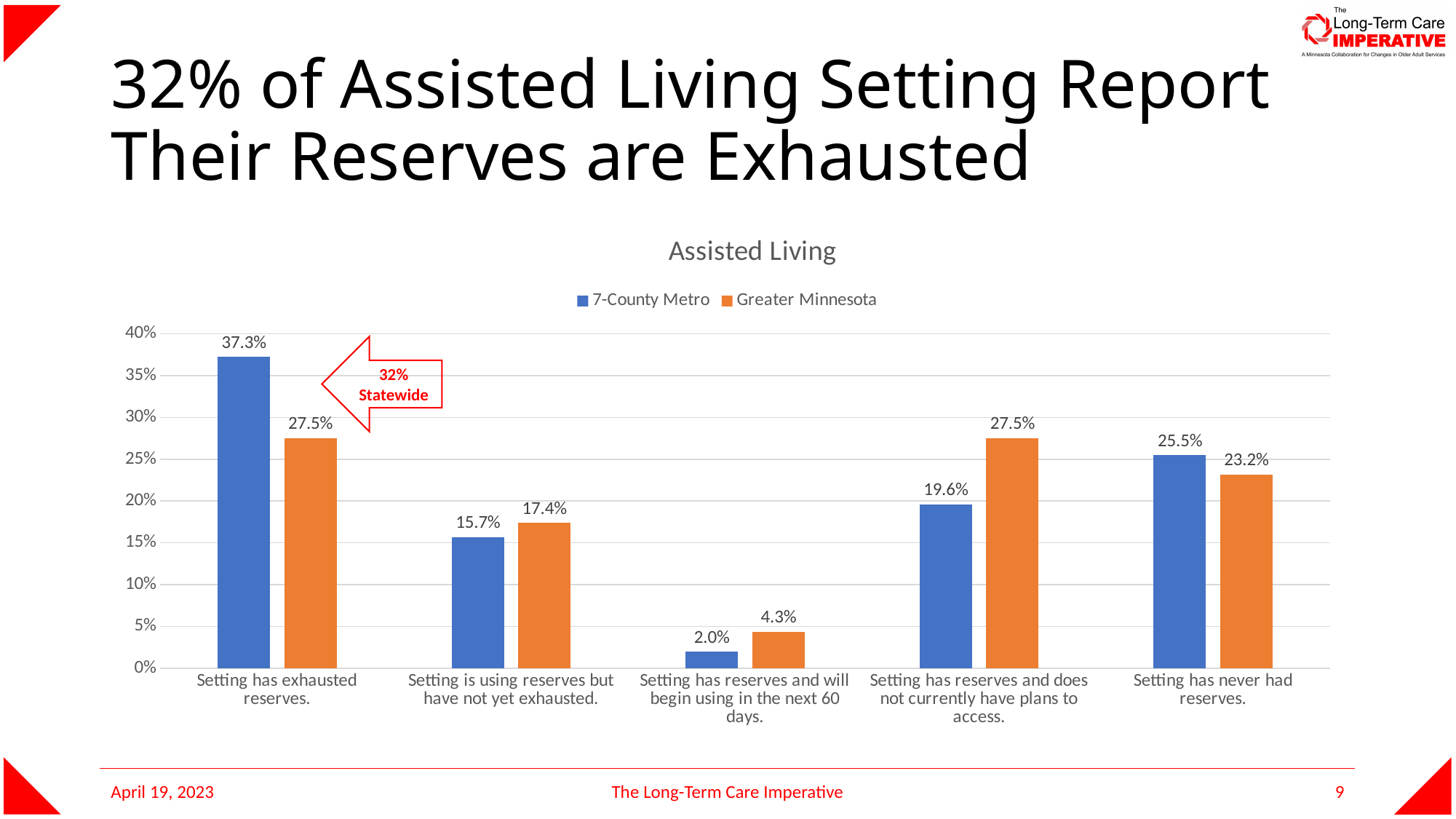
Which category has the lowest Greater Minnesota value? Setting has reserves and will begin using in the next 60 days. What is the Greater Minnesota value for "Setting has never had reserves."? 23.2% What kind of chart is shown on the slide? bar chart How many categories are shown on the x axis? 5 How many series does the legend list? 2 What is the Greater Minnesota value for "Setting has reserves and will begin using in the next 60 days."? 4.3% What is the difference between the 7-County Metro and Greater Minnesota values for "Setting has exhausted reserves."? 9.8% What is the 7-County Metro value for "Setting has exhausted reserves."? 37.3% Which category has the highest 7-County Metro value? Setting has exhausted reserves. What statewide percentage does the red arrow annotation on the chart show? 32% Statewide Is the 7-County Metro value for "Setting is using reserves but have not yet exhausted." greater or less than 20%? less For "Setting has reserves and does not currently have plans to access.", which series has the larger value, 7-County Metro or Greater Minnesota? Greater Minnesota